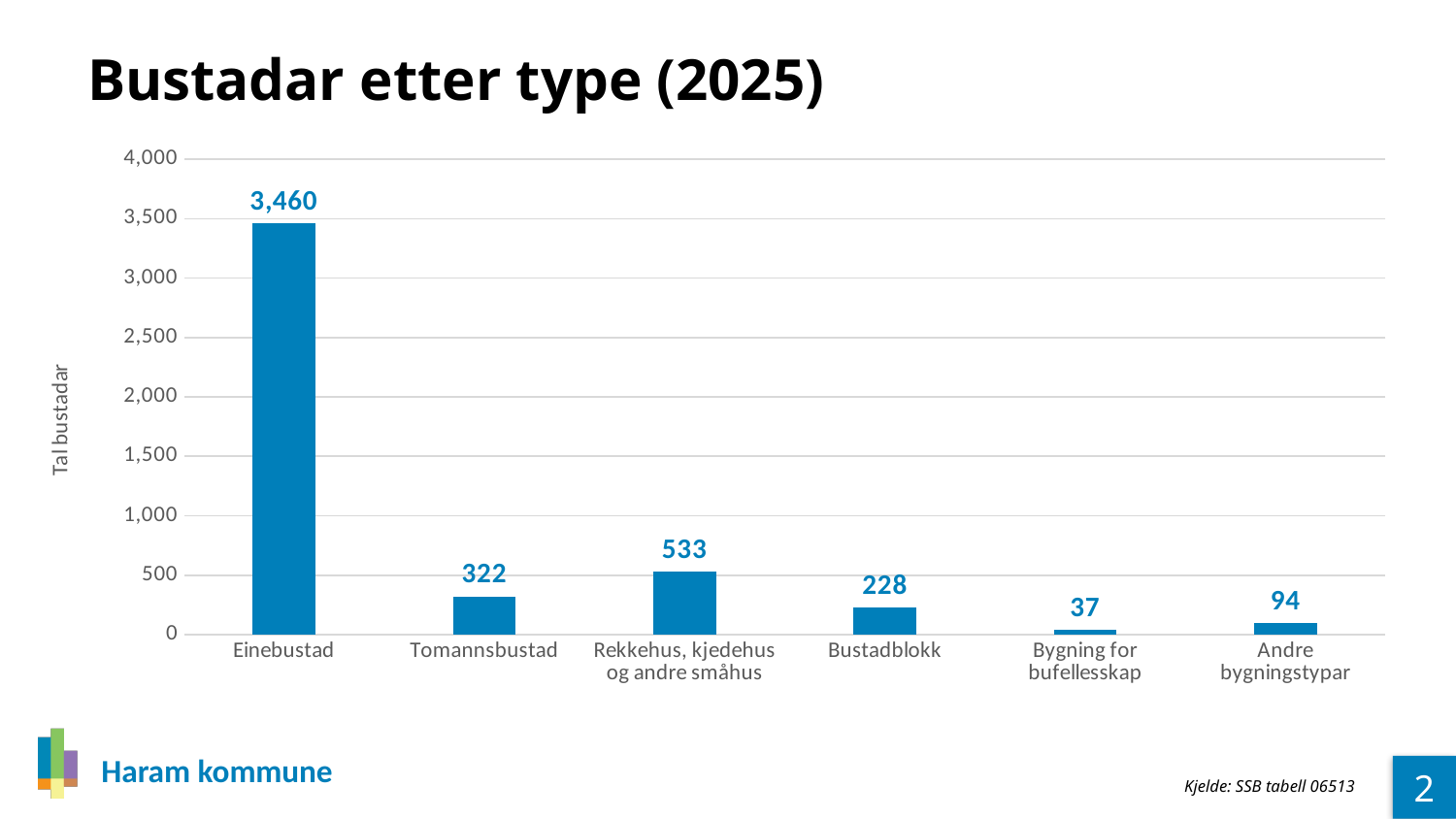
What is the label of the y axis? Tal bustadar What is the value for Bygning for bufellesskap? 37 What is the value for Einebustad? 3,460 What is the value for Rekkehus, kjedehus og andre småhus? 533 What is the difference between the values for Rekkehus, kjedehus og andre småhus and Tomannsbustad? 211 What kind of chart is shown on the slide? bar chart Which category has the lowest value? Bygning for bufellesskap How many categories are shown on the x axis? 6 Is the value for Tomannsbustad greater or less than 500? less What is the title of the chart? Bustadar etter type (2025) Which category has the highest value? Einebustad Which is larger, the value for Bustadblokk or the value for Andre bygningstypar? Bustadblokk